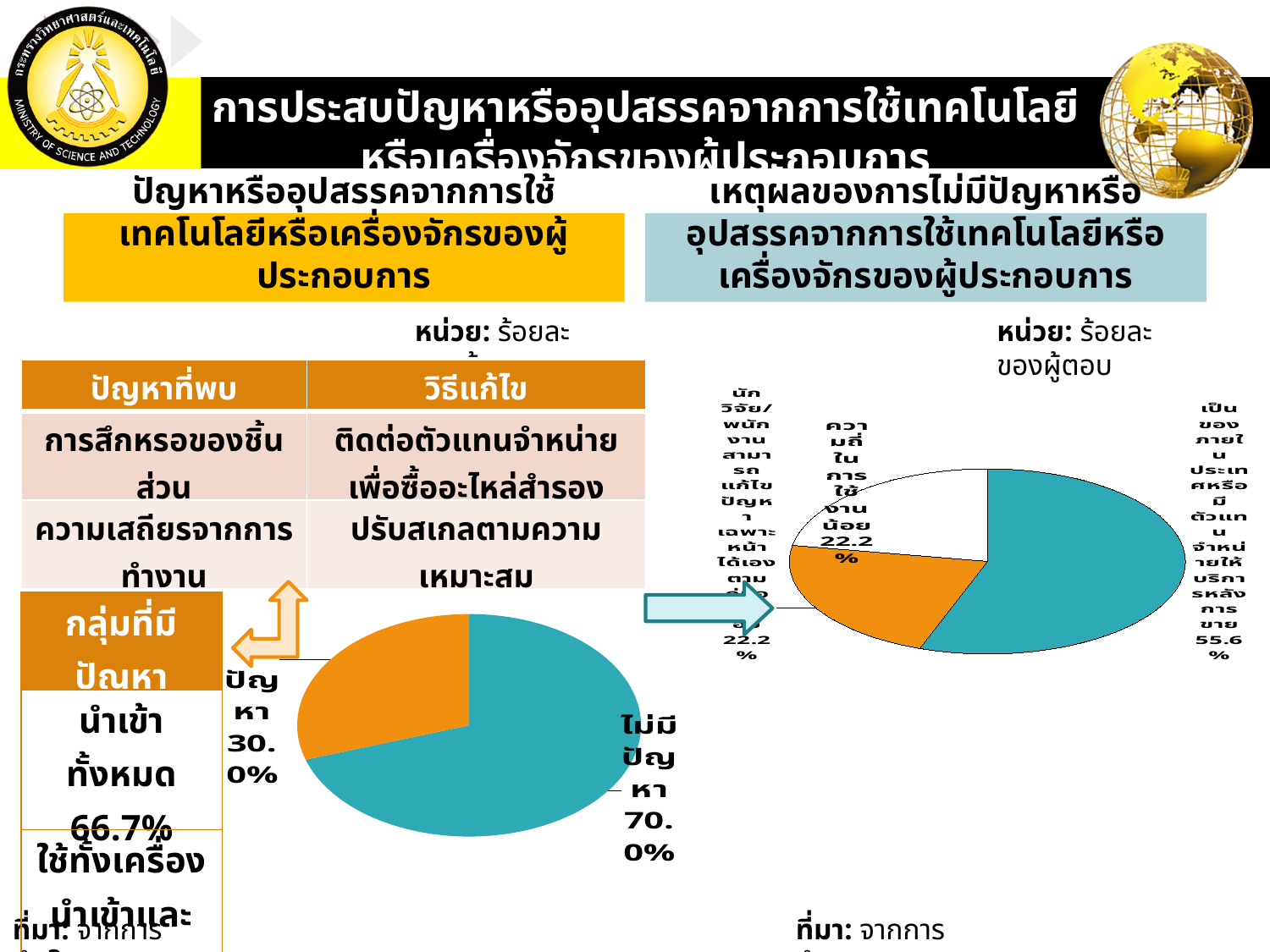
In the left pie chart, what is the difference in percentage points between 'ไม่มีปัญหา' and 'ปัญหา'? 40.0 percentage points In the left pie chart, what percentage is shown for 'ไม่มีปัญหา'? 70.0% In the right pie chart, what percentage is shown for 'ความถี่ในการใช้งานน้อย'? 22.2% In the right pie chart, which slice is the largest? เป็นของภายในประเทศหรือมีตัวแทนจำหน่ายให้บริการหลังการขาย In the left pie chart, which slice is larger: 'ปัญหา' or 'ไม่มีปัญหา'? ไม่มีปัญหา In the left pie chart, what percentage is shown for 'ปัญหา'? 30.0% How many slices does the right pie chart have? 3 In the right pie chart, what percentage is shown for the slice 'เป็นของภายในประเทศหรือมีตัวแทนจำหน่ายให้บริการหลังการขาย'? 55.6% What type of chart is shown on the left side of the slide under the heading 'ปัญหาหรืออุปสรรคจากการใช้เทคโนโลยีหรือเครื่องจักรของผู้ประกอบการ'? Pie chart What unit is stated above the right pie chart? ร้อยละของผู้ตอบ How many slices does the left pie chart have? 2 What type of chart is shown on the right side of the slide under the heading 'เหตุผลของการไม่มีปัญหาหรืออุปสรรคจากการใช้เทคโนโลยีหรือเครื่องจักรของผู้ประกอบการ'? Pie chart